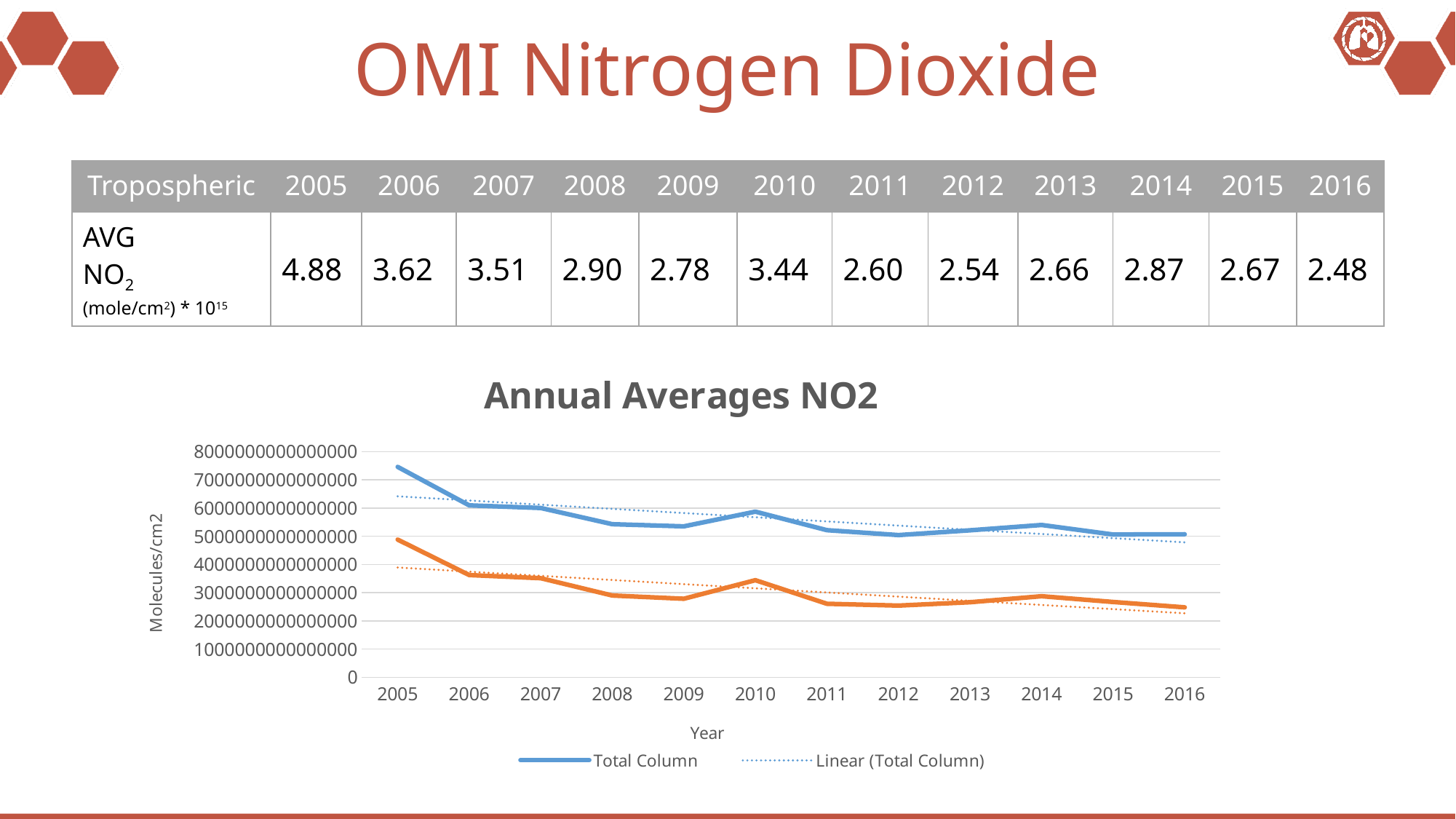
How many entries does the legend of the Annual Averages NO2 chart list? 2 How many years are plotted along the x axis of the Annual Averages NO2 chart? 12 In the Annual Averages NO2 chart, which year has the highest Total Column value? 2005 In the Annual Averages NO2 chart, which year has the larger Total Column value, 2005 or 2006? 2005 In the Annual Averages NO2 chart, is the Total Column value for 2005 greater or less than 7000000000000000? greater What kind of chart is shown under the title "Annual Averages NO2"? line chart What is the label on the y axis of the Annual Averages NO2 chart? Molecules/cm2 In the Annual Averages NO2 chart, is the orange line's value for 2011 greater or less than 3000000000000000? less In the Annual Averages NO2 chart, which year has the larger Total Column value, 2009 or 2010? 2010 In the Annual Averages NO2 chart, is the Total Column value for 2010 greater or less than 5000000000000000? greater In the Annual Averages NO2 chart, does the Total Column series generally rise or fall from 2005 to 2016? fall